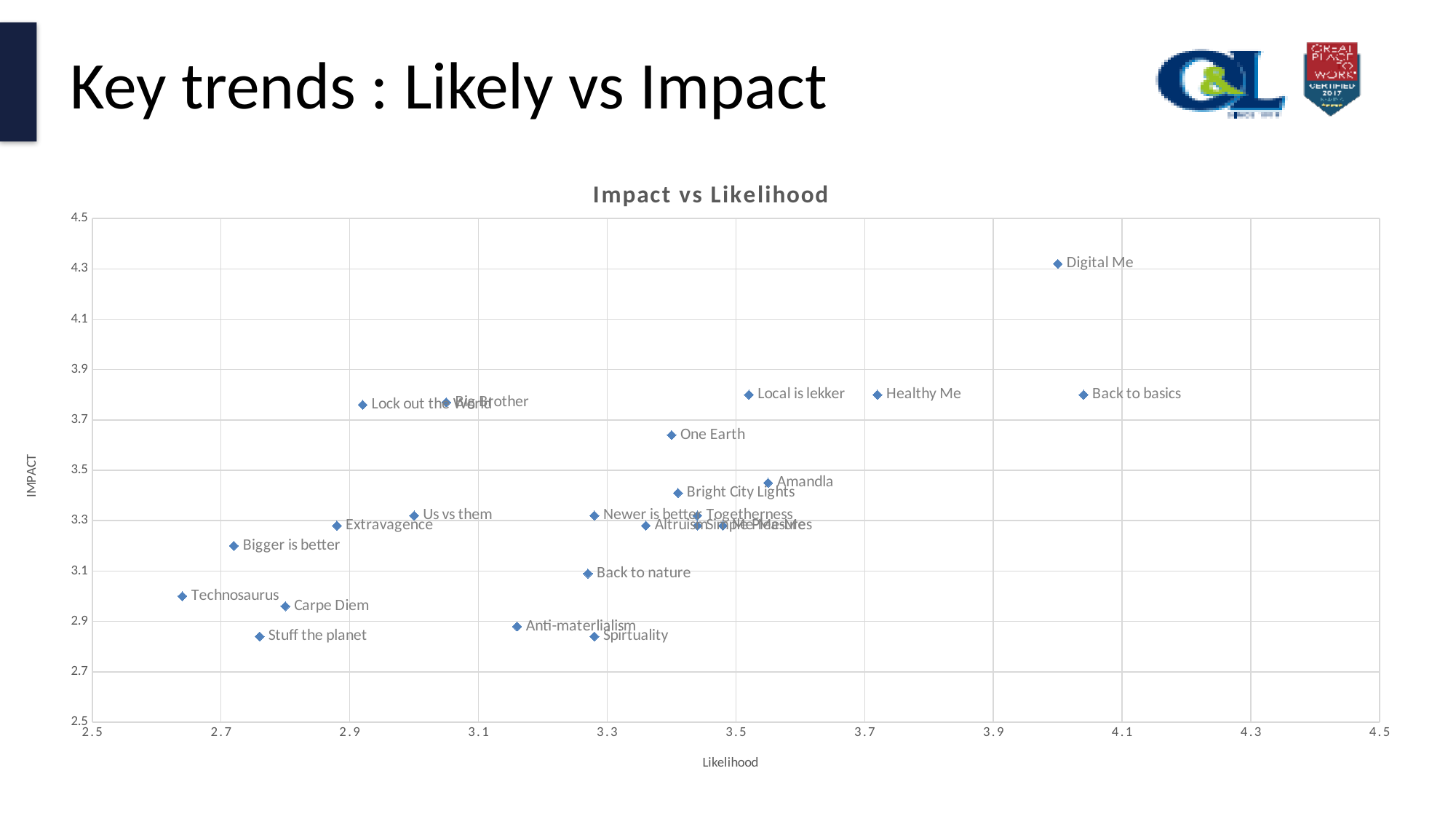
Is the likelihood value for Back to basics greater or less than 3.9? greater Is the impact value for Digital Me greater or less than 4.1? greater What kind of chart is shown on the slide? Scatter chart Which trend has the highest impact value on the chart? Digital Me Is the impact value for Stuff the planet greater or less than 2.9? less Which has the higher impact value, Digital Me or One Earth? Digital Me What is the title of the chart? Impact vs Likelihood Which trend has the lowest likelihood value on the chart? Technosaurus What is the label of the horizontal axis of the chart? Likelihood Which has the higher likelihood value, Technosaurus or Back to basics? Back to basics